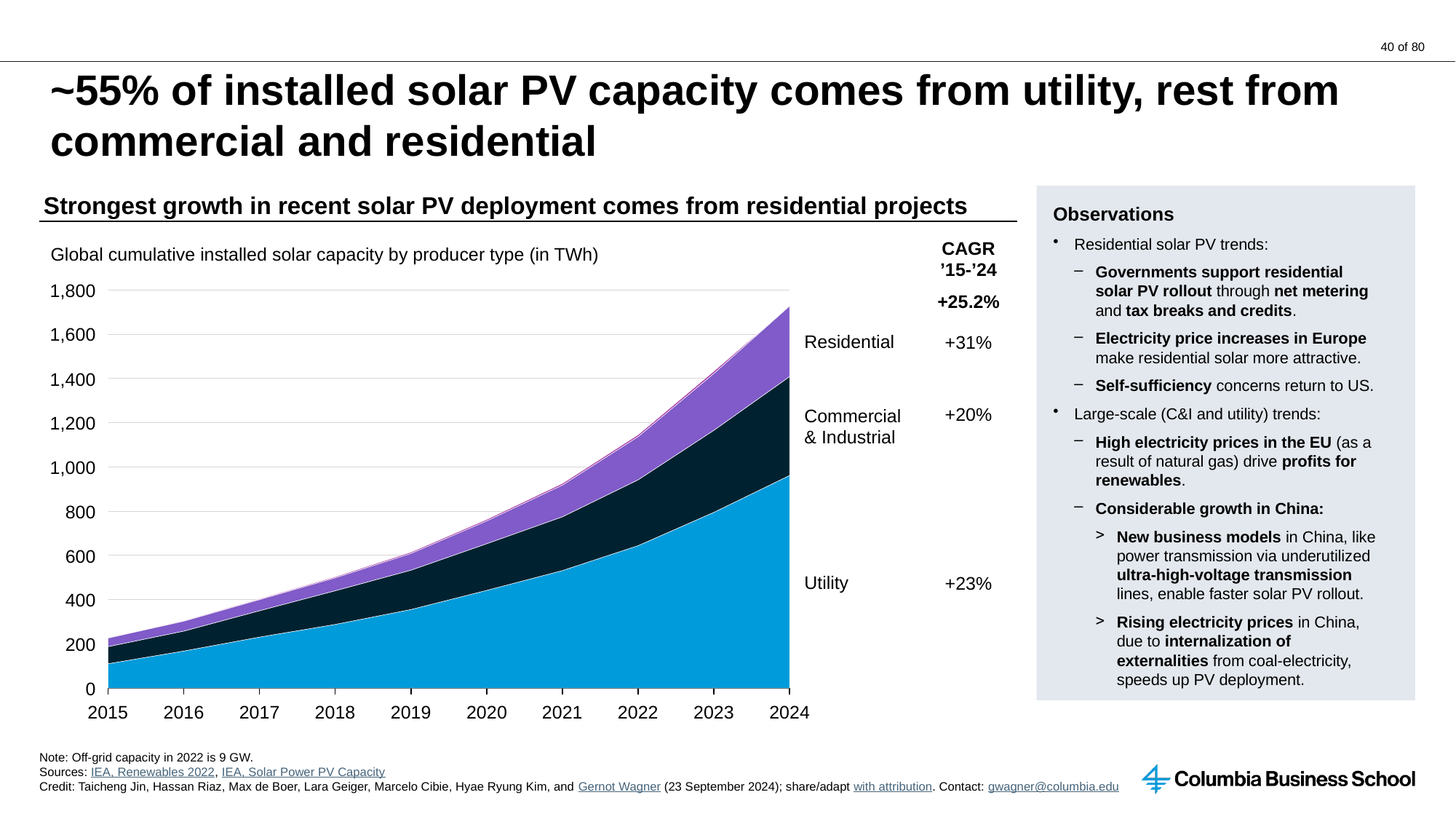
Which producer type has the highest CAGR '15-'24? Residential What is the CAGR for Utility from '15 to '24? +23% Is the Utility installed capacity in 2024 greater or less than 1,000 TWh? less What unit is the installed solar capacity measured in, according to the chart subtitle? TWh Is the total installed solar capacity in 2024 greater or less than 1,600 TWh? greater Which producer type has the lowest CAGR '15-'24? Commercial & Industrial What is the CAGR for Commercial & Industrial from '15 to '24? +20% What is the CAGR for Residential from '15 to '24? +31% Does global cumulative installed solar capacity rise or fall from 2015 to 2024? Rises How many years are shown on the x axis of the chart? 10 What is the overall CAGR '15-'24 shown for total installed solar capacity? +25.2% What kind of chart is shown on the slide? Stacked area chart